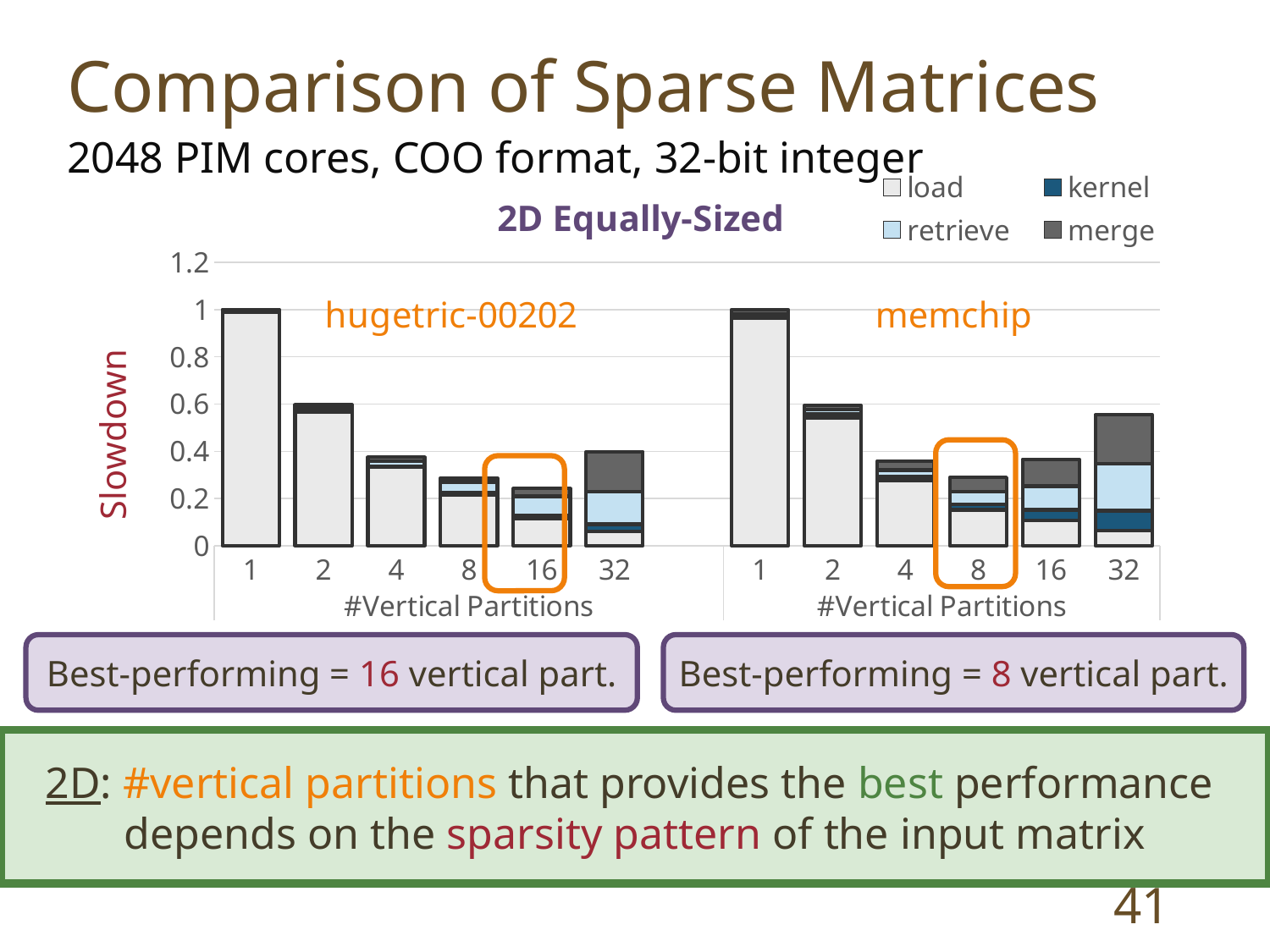
For hugetric-00202, which number of vertical partitions has the highest Slowdown? 1 For memchip, which number of vertical partitions has the lowest Slowdown? 8 How many series does the chart legend list? 4 How many #Vertical Partitions categories are plotted for the hugetric-00202 matrix? 6 For hugetric-00202, does the Slowdown rise or fall as the number of vertical partitions goes from 1 to 16? fall For hugetric-00202, which number of vertical partitions has the lowest Slowdown? 16 Is the Slowdown for memchip with 32 vertical partitions greater or less than 0.4? greater What is the label on the y axis of the chart? Slowdown What kind of chart is shown on the slide? stacked bar chart Is the Slowdown for hugetric-00202 with 16 vertical partitions greater or less than 0.4? less For memchip, which has the larger Slowdown: 16 or 32 vertical partitions? 32 What is the Slowdown value for hugetric-00202 with 1 vertical partition? 1